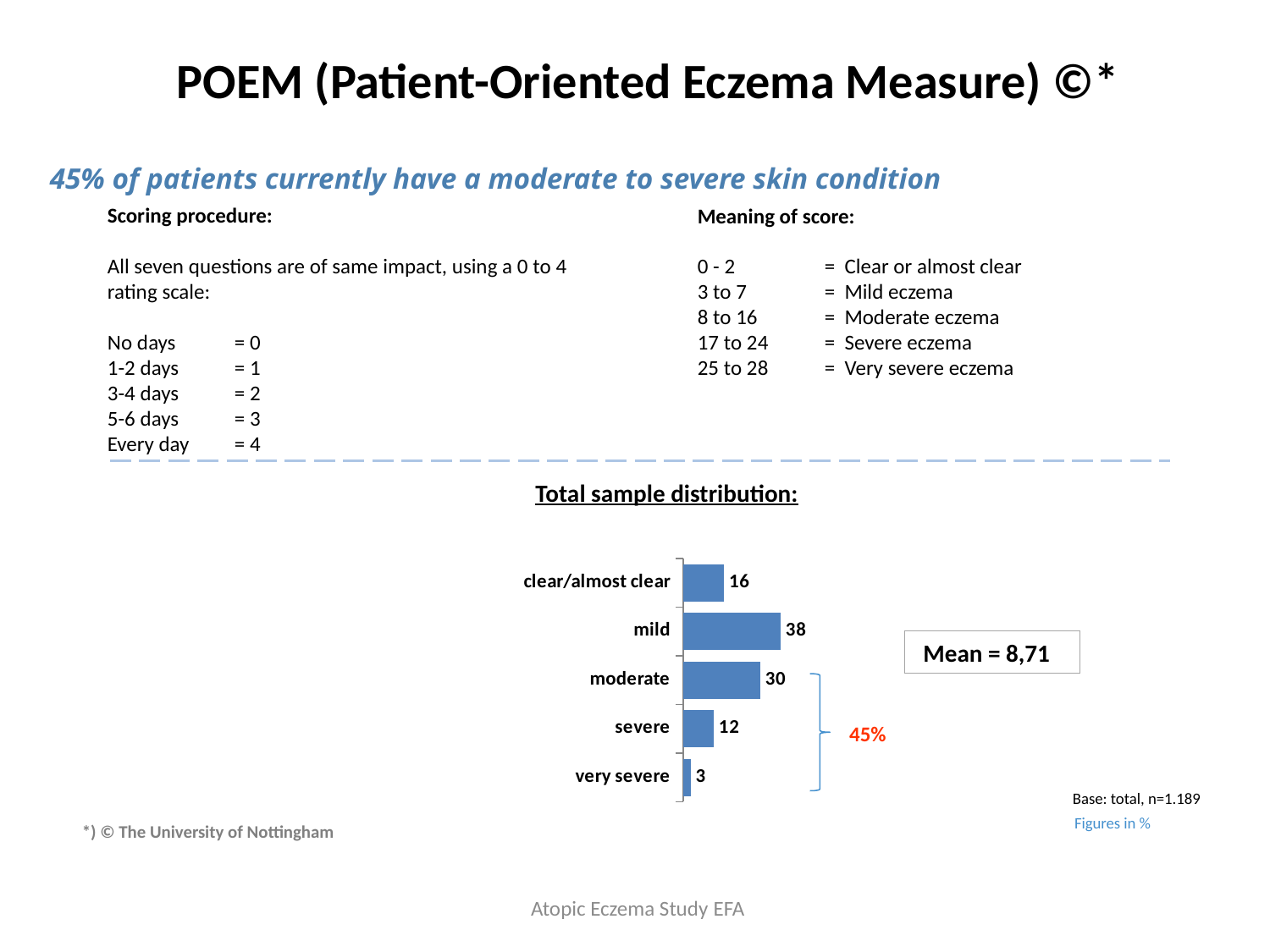
Which category has the lowest value in the Total sample distribution chart? very severe What mean value is shown next to the Total sample distribution chart? 8,71 What is the combined total of the 'moderate', 'severe' and 'very severe' categories in the Total sample distribution chart? 45 What is the value for the 'mild' category in the Total sample distribution chart? 38 What kind of chart is the Total sample distribution chart? bar chart What is the value for the 'very severe' category in the Total sample distribution chart? 3 What is the value for 'clear/almost clear' in the Total sample distribution chart? 16 What is the difference between the 'mild' and 'moderate' values in the Total sample distribution chart? 8 Which is larger in the Total sample distribution chart, 'clear/almost clear' or 'severe'? clear/almost clear Which category has the highest value in the Total sample distribution chart? mild How many categories are shown in the Total sample distribution chart? 5 What is the difference between the 'severe' and 'very severe' values in the Total sample distribution chart? 9